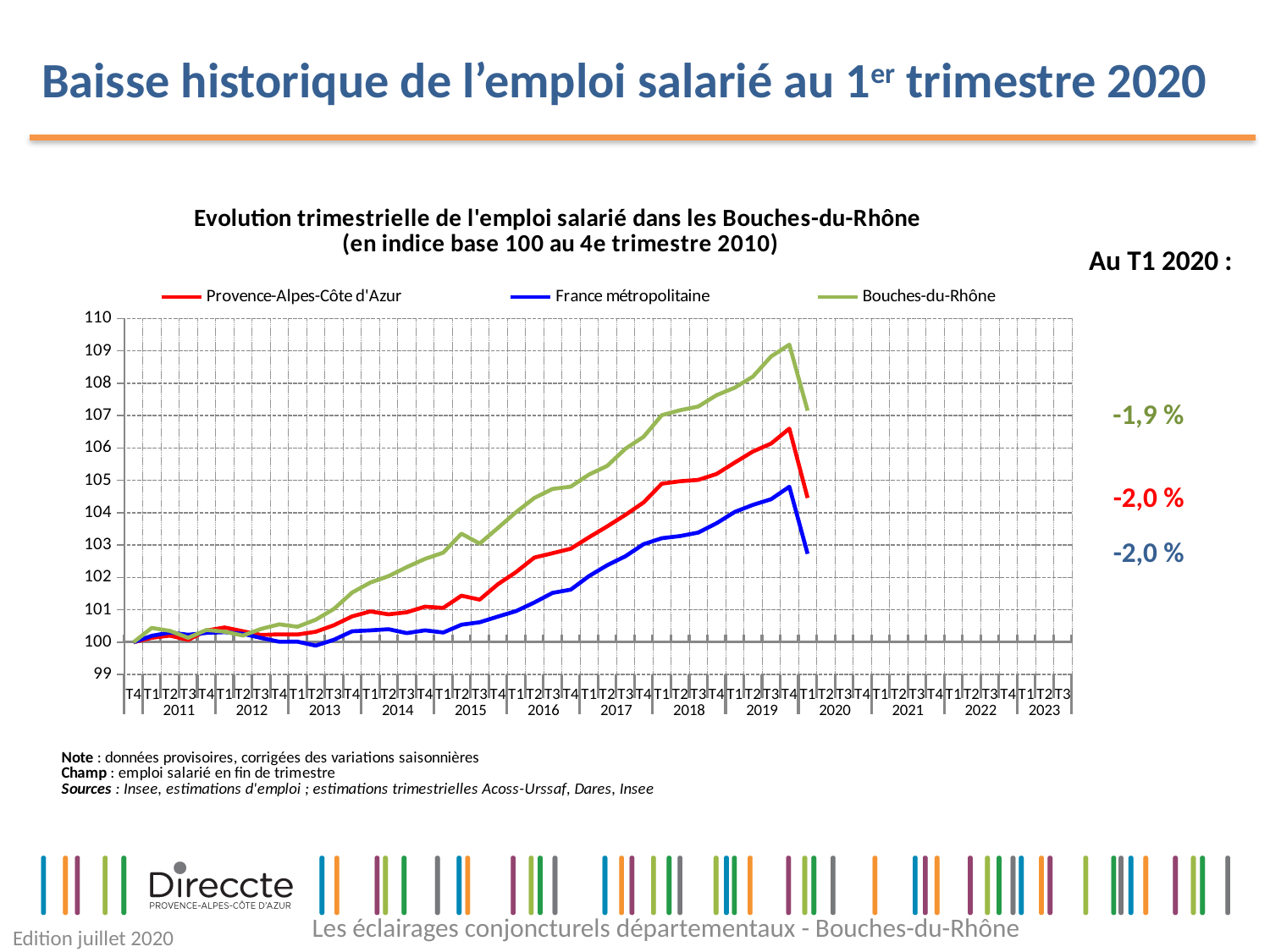
According to the annotation on the right of the chart, what is the change for Provence-Alpes-Côte d'Azur at T1 2020? -2,0 % How many series does the legend of the chart list? 3 According to the annotation on the right of the chart, what is the change for Bouches-du-Rhône at T1 2020? -1,9 % At T4 2019, which is larger: the value for Provence-Alpes-Côte d'Azur or the value for France métropolitaine? Provence-Alpes-Côte d'Azur Which series has the lowest value in the chart at T1 2020? France métropolitaine What kind of chart is shown on the slide? line chart Which series is drawn in green in the chart? Bouches-du-Rhône At T4 2019, is the value for Bouches-du-Rhône greater or less than 108? greater Which series reaches the highest value in the chart at T4 2019? Bouches-du-Rhône At T1 2020, is the value for France métropolitaine greater or less than 104? less Between T4 2019 and T1 2020, do the three series rise or fall? fall What is the base period of the index used in the chart, according to its title? 4e trimestre 2010